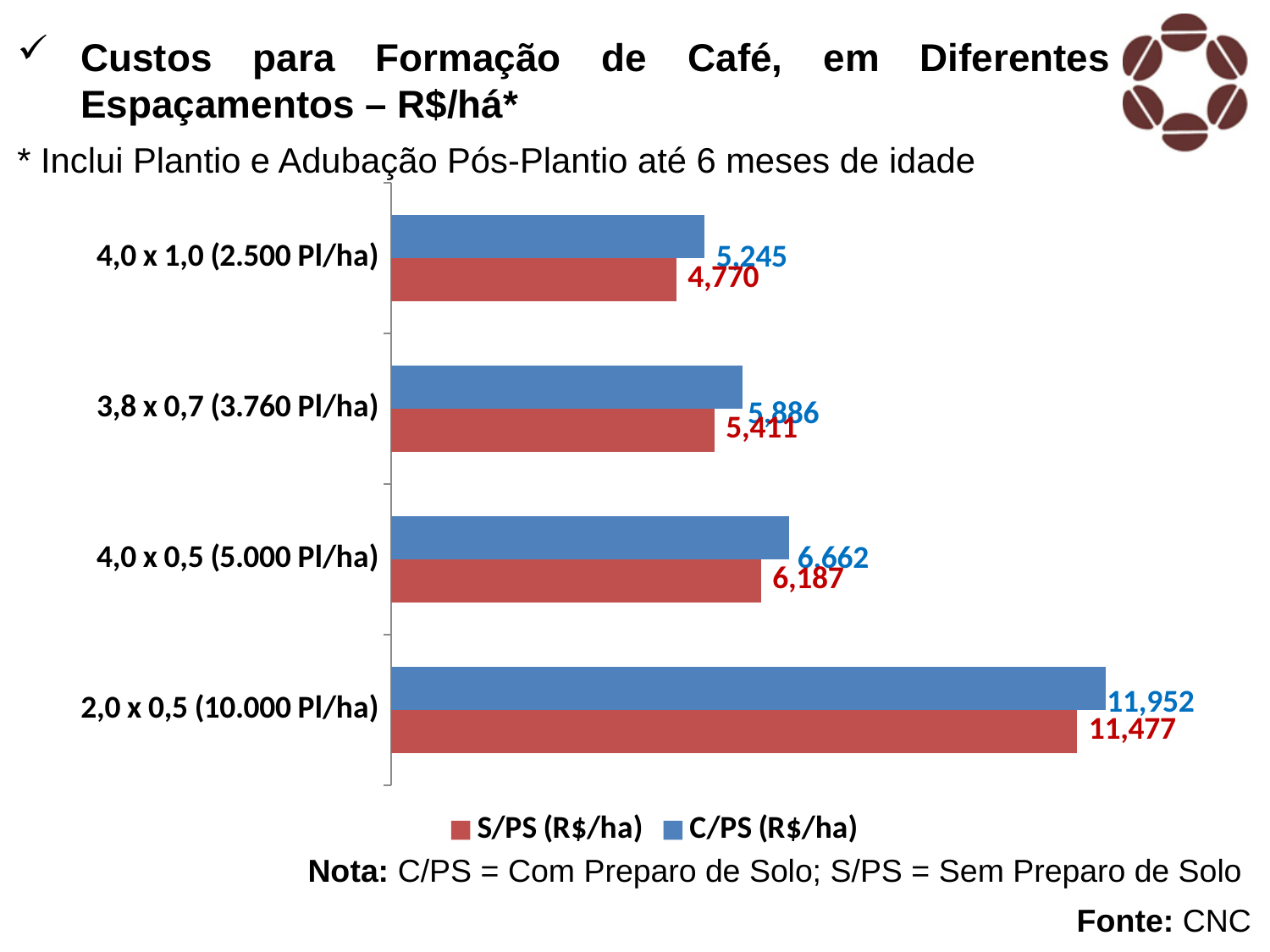
What colour are the S/PS (R$/ha) bars? Red Which spacing has the lowest S/PS (R$/ha) cost? 4,0 x 1,0 (2.500 Pl/ha) What is the S/PS (R$/ha) value for the 4,0 x 0,5 (5.000 Pl/ha) spacing? 6,187 Which spacing has the highest C/PS (R$/ha) cost? 2,0 x 0,5 (10.000 Pl/ha) What is the C/PS (R$/ha) value for the 3,8 x 0,7 (3.760 Pl/ha) spacing? 5,886 What is the difference between the C/PS and S/PS values for the 2,0 x 0,5 (10.000 Pl/ha) spacing? 475 How many series does the legend list? 2 What is the C/PS (R$/ha) value for the 2,0 x 0,5 (10.000 Pl/ha) spacing? 11,952 Which is larger for the 4,0 x 0,5 (5.000 Pl/ha) spacing: the C/PS value or the S/PS value? C/PS (R$/ha) What type of chart is shown on the slide? Bar chart What is the S/PS (R$/ha) value for the 4,0 x 1,0 (2.500 Pl/ha) spacing? 4,770 How many spacing categories are shown in the chart? 4